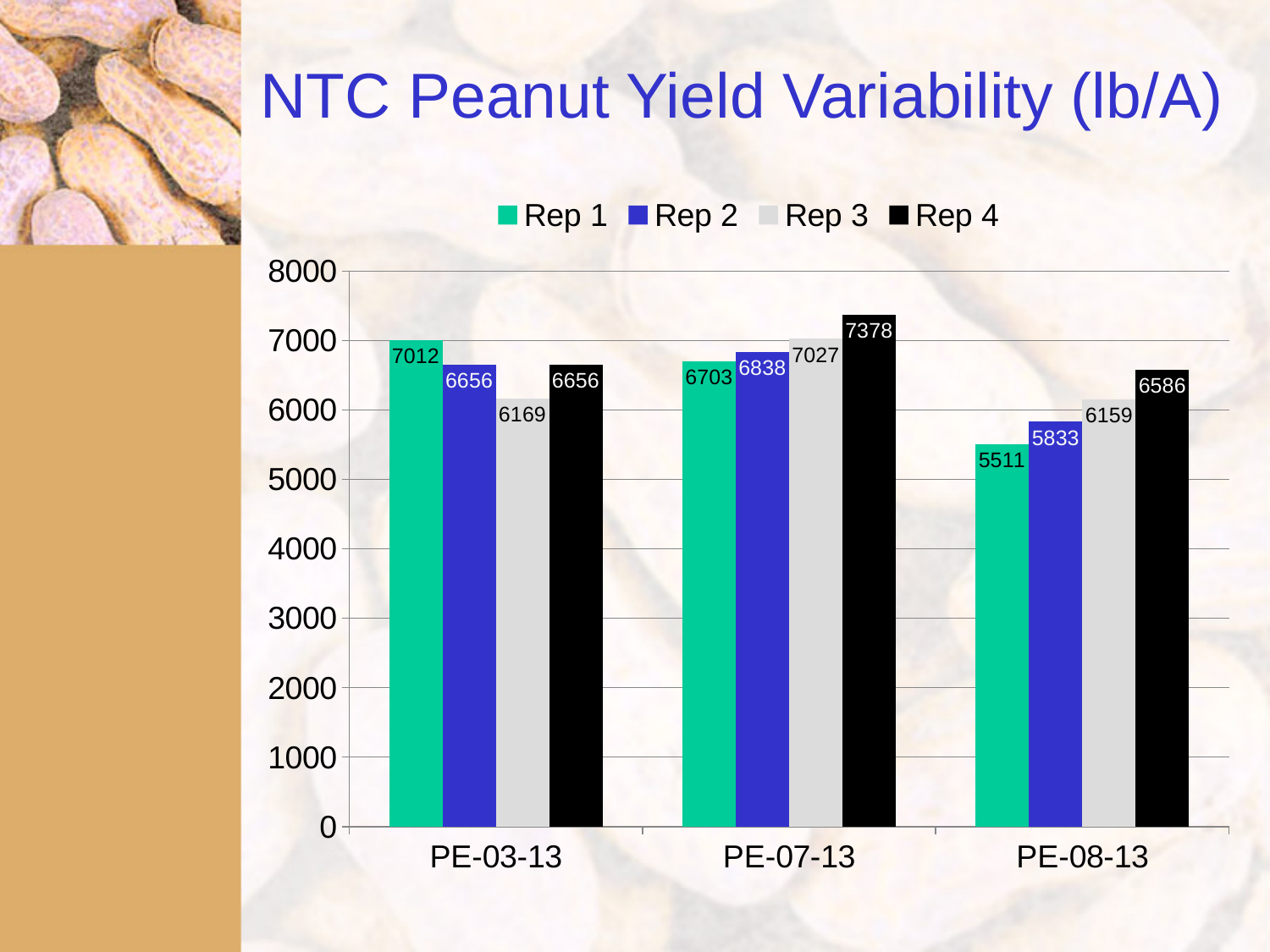
Which rep has the lowest yield for PE-03-13? Rep 3 What kind of chart is shown on the slide? Bar chart Which is larger, the Rep 1 yield for PE-03-13 or the Rep 1 yield for PE-08-13? PE-03-13 What is the Rep 4 yield for PE-07-13? 7378 What is the Rep 2 yield for PE-07-13? 6838 How many series does the legend list? 4 How many categories are shown on the x axis? 3 What is the Rep 1 yield for PE-03-13? 7012 What is the difference between the Rep 4 and Rep 1 yields for PE-07-13? 675 Is the Rep 1 yield for PE-08-13 greater or less than 6000? less Which rep has the highest yield for PE-08-13? Rep 4 What is the Rep 3 yield for PE-08-13? 6159